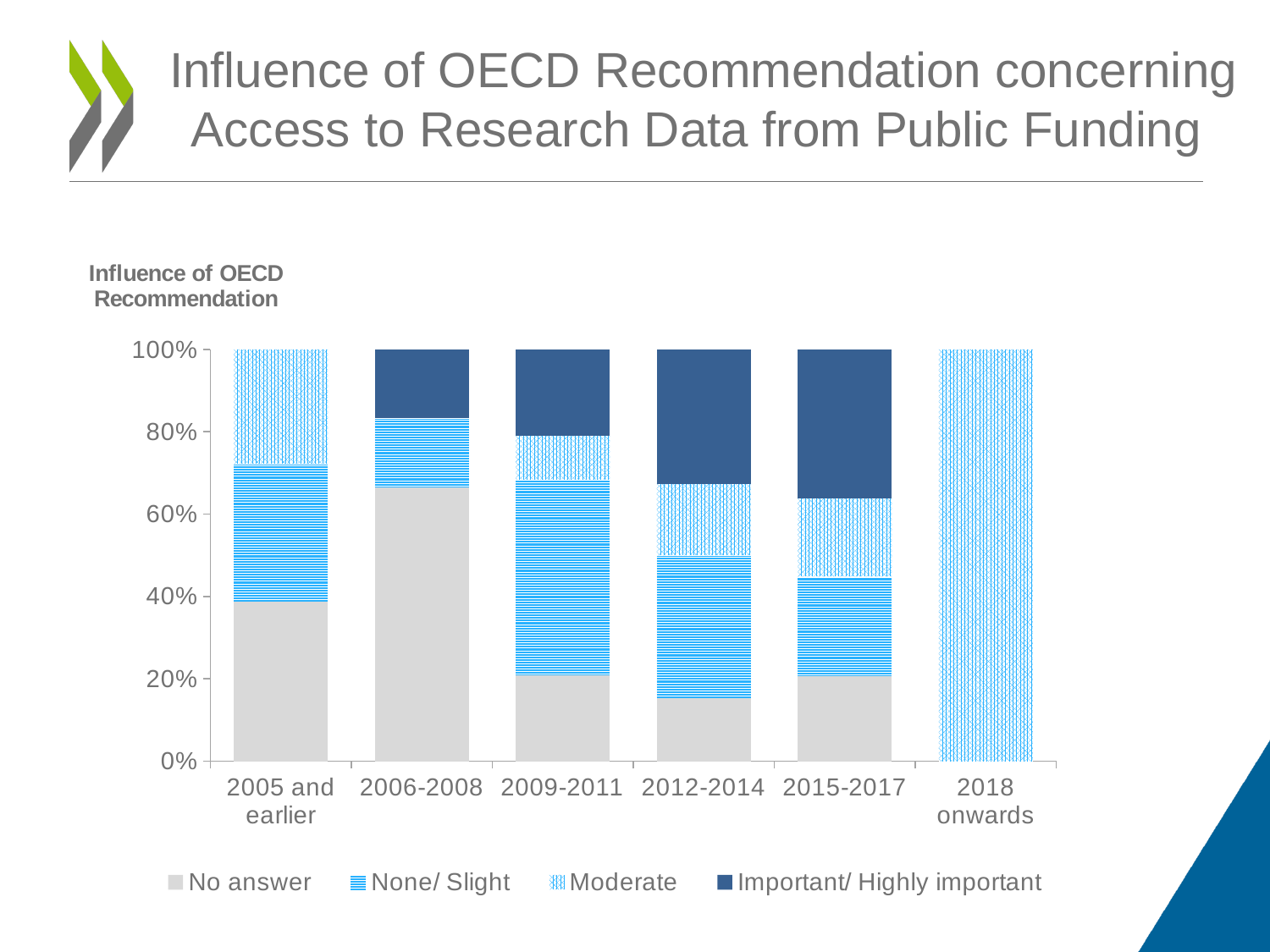
How many time-period categories are shown on the x axis? 6 What kind of chart is shown on the slide? Stacked bar chart Which category's bar consists entirely of the 'Moderate' series? 2018 onwards Which category has no 'Important/ Highly important' segment apart from 2018 onwards? 2005 and earlier Which has a larger 'Important/ Highly important' share, 2006-2008 or 2012-2014? 2012-2014 Which category has the smallest 'No answer' share? 2012-2014 Is the 'No answer' share for 2012-2014 greater or less than 20%? less Is the 'No answer' share for 2006-2008 greater or less than 60%? greater Which category has the largest 'No answer' share? 2006-2008 What is the title shown above the chart's y axis? Influence of OECD Recommendation How many series does the legend list? 4